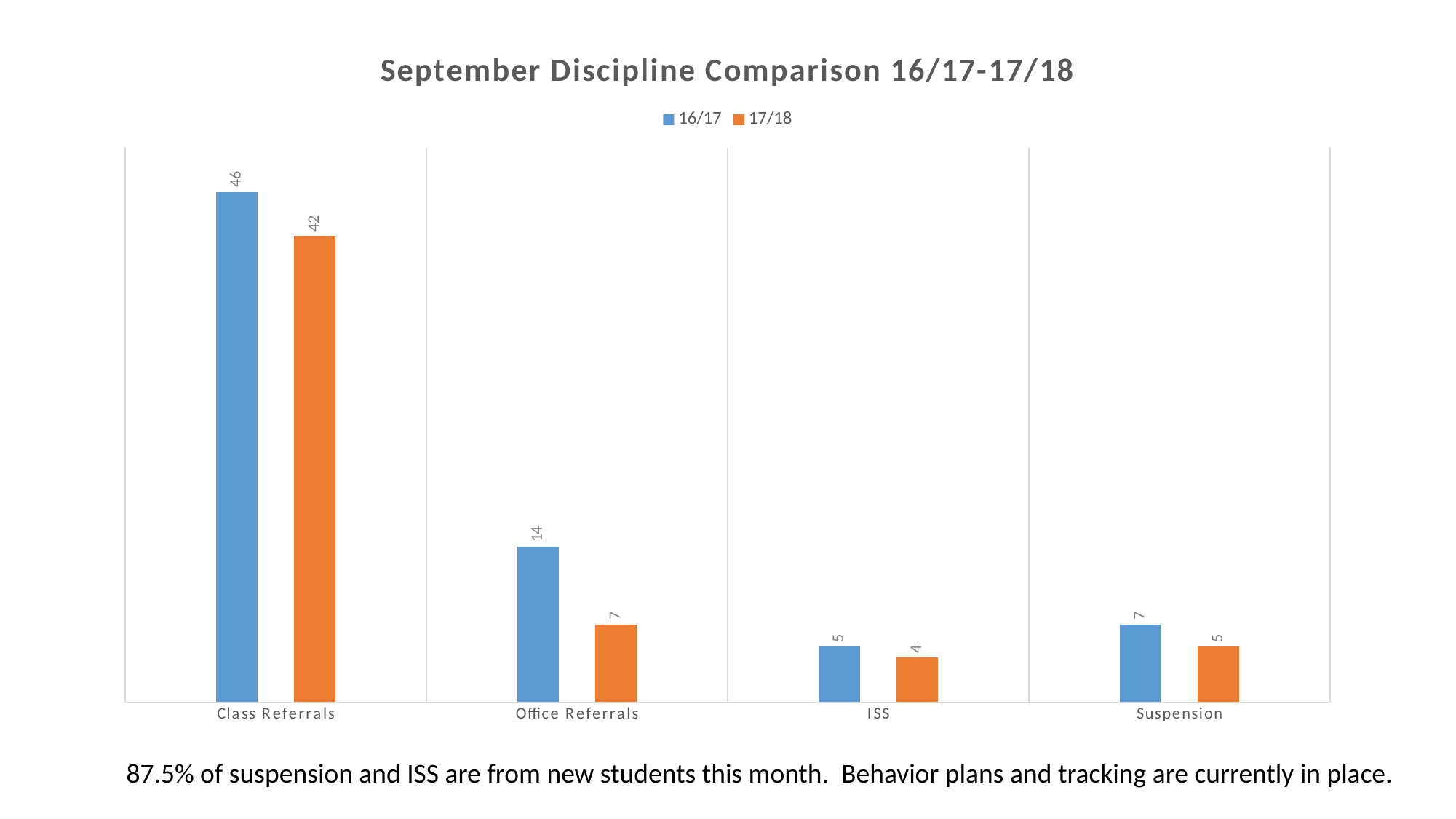
Which category has the highest 17/18 value? Class Referrals What type of chart is shown on the slide? Bar chart What is the difference between the 16/17 and 17/18 values for Class Referrals? 4 Which category has the lowest 16/17 value? ISS What is the 16/17 value for Class Referrals? 46 What is the 17/18 value for ISS? 4 What is the 16/17 value for Suspension? 7 How many series does the legend list? 2 Which is larger for Suspension, the 16/17 value or the 17/18 value? 16/17 What is the difference between the 16/17 and 17/18 values for Office Referrals? 7 How many categories are shown on the x axis? 4 What is the 17/18 value for Office Referrals? 7